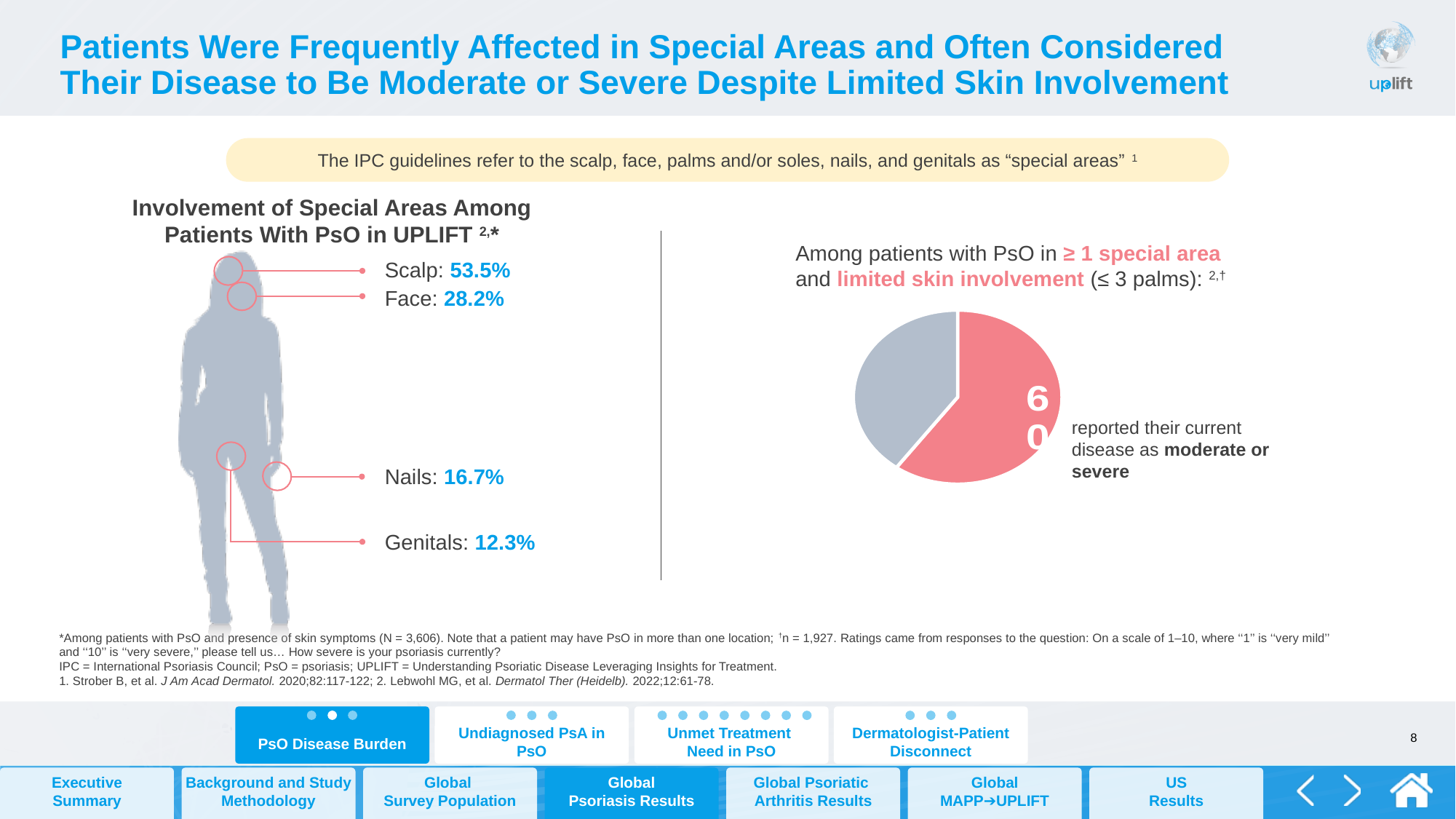
In the pie chart, which slice is larger: the pink slice or the grey slice? The pink slice In the pie chart, what colour is the slice representing patients who reported their disease as moderate or severe? Pink In the pie chart, what value is printed on the slice for patients who reported their current disease as moderate or severe? 60 In the 'Involvement of Special Areas Among Patients With PsO in UPLIFT' figure, which special area has the lowest percentage? Genitals How many slices does the pie chart have? 2 In the 'Involvement of Special Areas Among Patients With PsO in UPLIFT' figure, what percentage is shown for Scalp? 53.5% In the 'Involvement of Special Areas Among Patients With PsO in UPLIFT' figure, which special area has the highest percentage? Scalp In the 'Involvement of Special Areas Among Patients With PsO in UPLIFT' figure, which is larger: the percentage for Face or for Nails? Face In the 'Involvement of Special Areas Among Patients With PsO in UPLIFT' figure, what is the difference between the Scalp and Face percentages? 25.3 percentage points In the 'Involvement of Special Areas Among Patients With PsO in UPLIFT' figure, what percentage is shown for Nails? 16.7% What kind of chart is shown on the right side of the slide under the heading about patients with PsO in ≥ 1 special area and limited skin involvement? Pie chart In the 'Involvement of Special Areas Among Patients With PsO in UPLIFT' figure, how many special areas are labelled with a percentage? 4